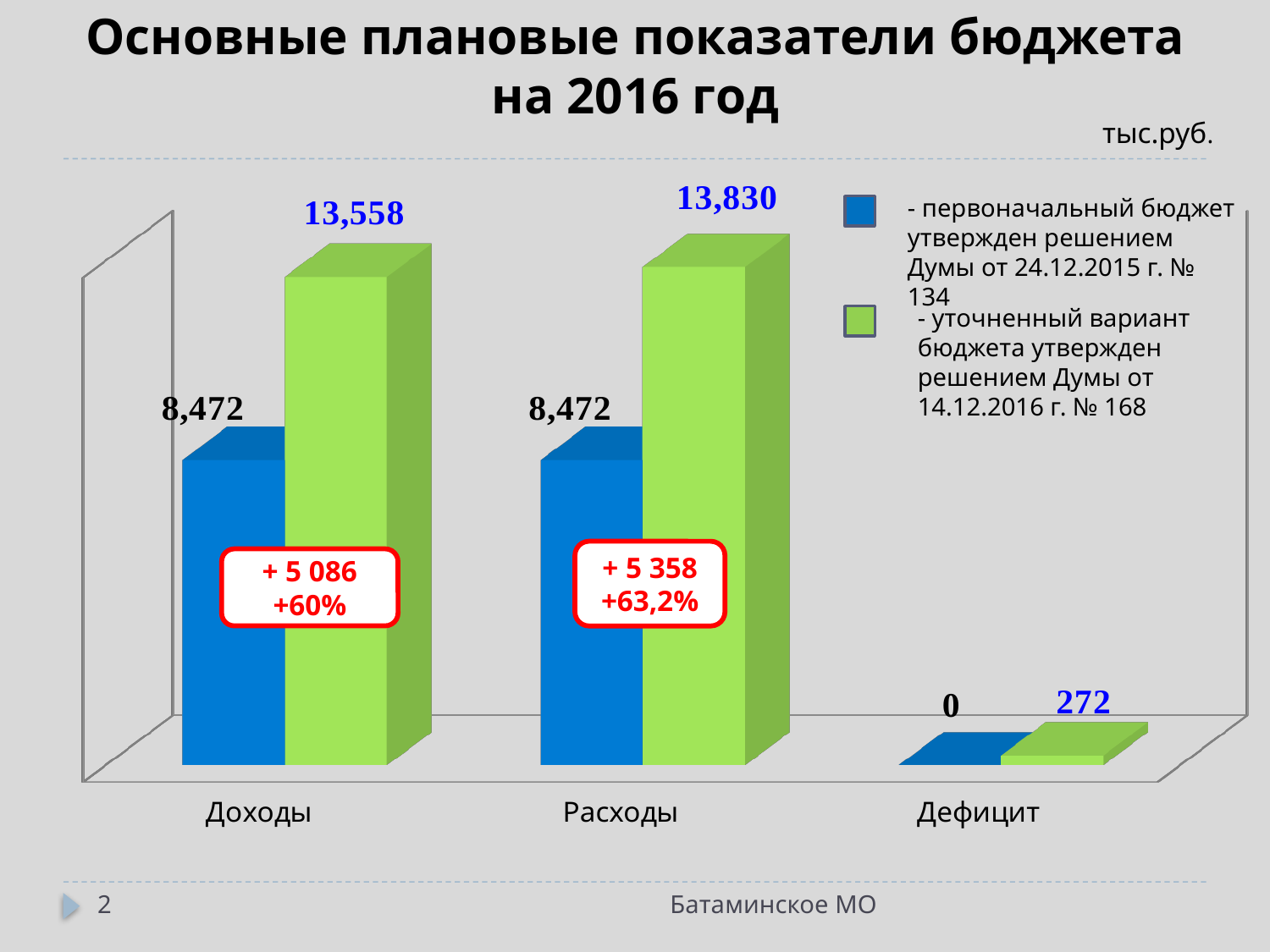
What is the value of the green (уточненный вариант) bar for Доходы? 13,558 What is the value of the green (уточненный вариант) bar for Дефицит? 272 What is the value of the blue (первоначальный бюджет) bar for Дефицит? 0 What is the value of the blue (первоначальный бюджет) bar for Расходы? 8,472 Which is larger: the green bar for Доходы or the green bar for Расходы? Расходы How many categories are shown on the x axis of the chart? 3 How many series does the legend list? 2 Which category has the highest value in the green (уточненный вариант) series? Расходы What type of chart is shown on the slide? Bar chart Which category has the lowest value in the blue (первоначальный бюджет) series? Дефицит What is the difference between the green bars for Расходы and Доходы? 272 What is the difference between the green and blue bars for Расходы? 5,358